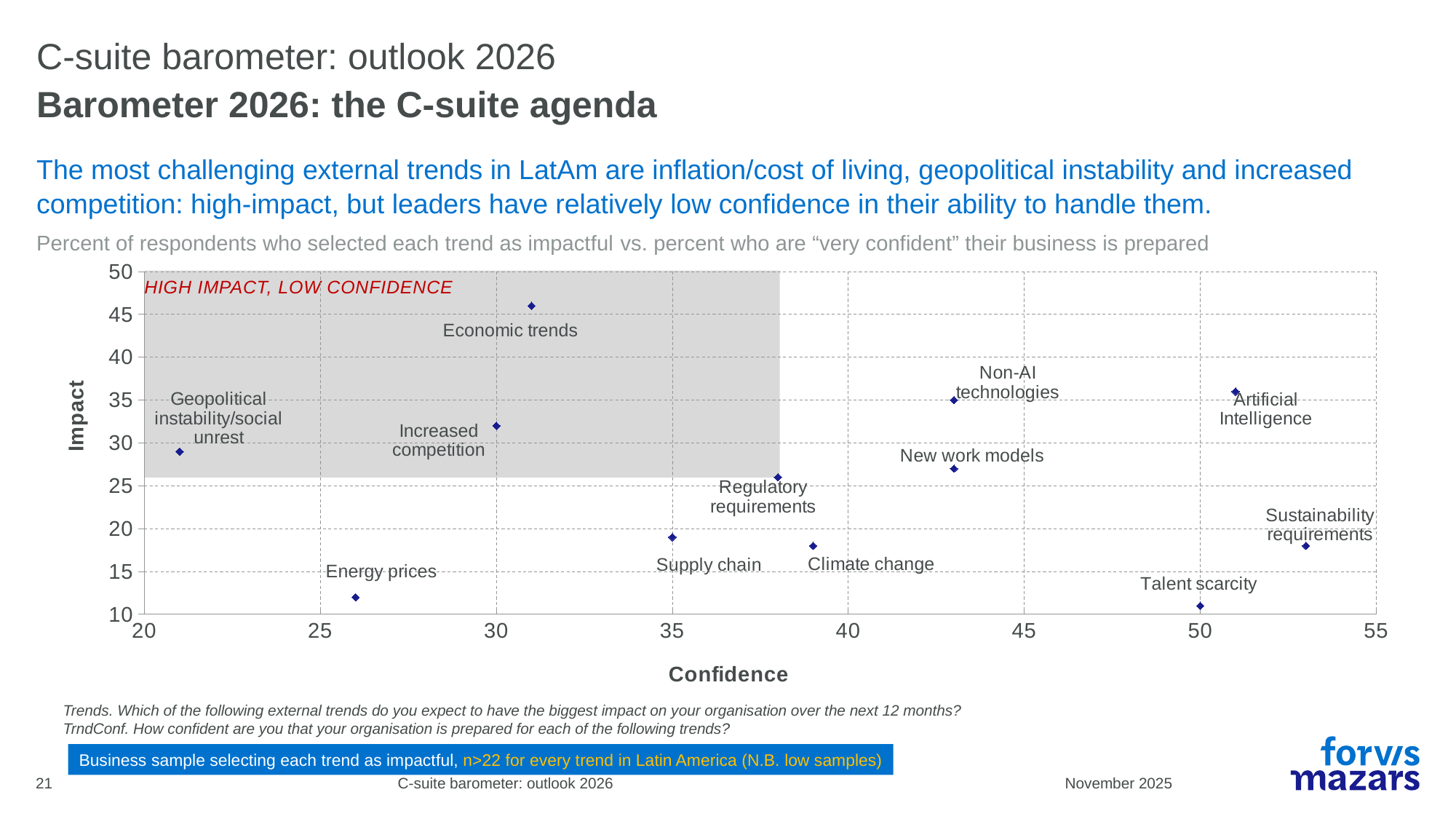
Which has the higher Impact value: Economic trends or Artificial Intelligence? Economic trends Is the Impact value for Energy prices greater or less than 15? less Which trend has the highest Confidence value? Sustainability requirements Which trend has the highest Impact value? Economic trends Is the Impact value for Economic trends greater or less than 45? greater What is the label of the horizontal axis? Confidence How many trends are plotted as points on the chart? 12 What label is written in the shaded grey region of the chart? HIGH IMPACT, LOW CONFIDENCE What kind of chart is shown on the slide? Scatter chart Is the Confidence value for Artificial Intelligence greater or less than 50? greater Which trend has the lowest Confidence value? Geopolitical instability/social unrest Which trend has the lowest Impact value? Talent scarcity